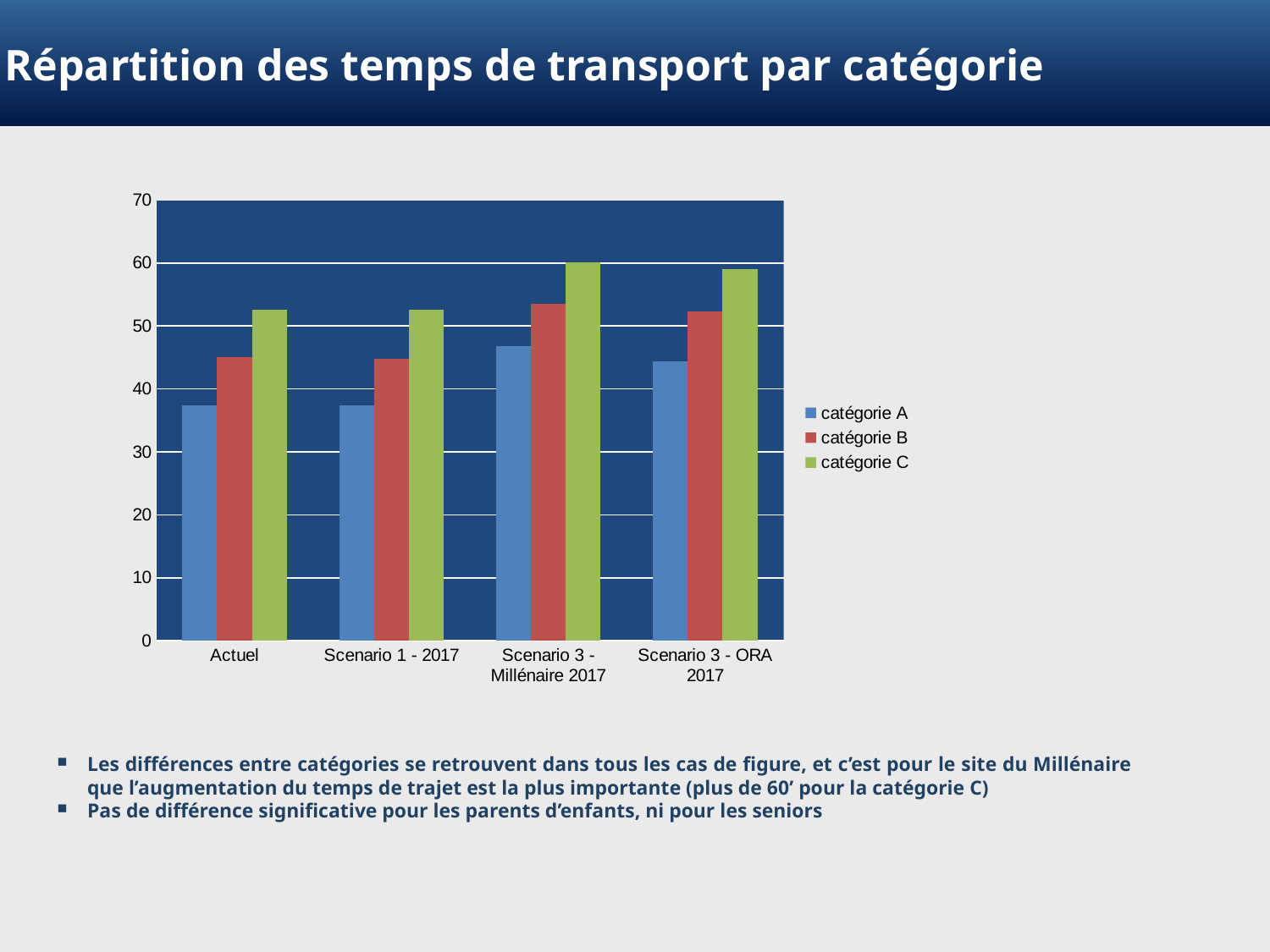
Is the value for catégorie C in the Scenario 1 - 2017 group greater or less than 50? greater What colour are the bars for catégorie C in the chart? green Is the value for catégorie A in the Actuel group greater or less than 40? less Which series has the highest bar in the Actuel group? catégorie C What is the title of the slide containing the chart? Répartition des temps de transport par catégorie How many series does the chart legend list? 3 How many categories are shown along the x axis of the chart? 4 Is the value for catégorie A in the Scenario 3 - Millénaire 2017 group greater or less than 50? less What kind of chart is shown on the slide? bar chart Which series has the lowest bar in the Scenario 3 - Millénaire 2017 group? catégorie A Which is larger for catégorie B: the value for Actuel or the value for Scenario 3 - Millénaire 2017? Scenario 3 - Millénaire 2017